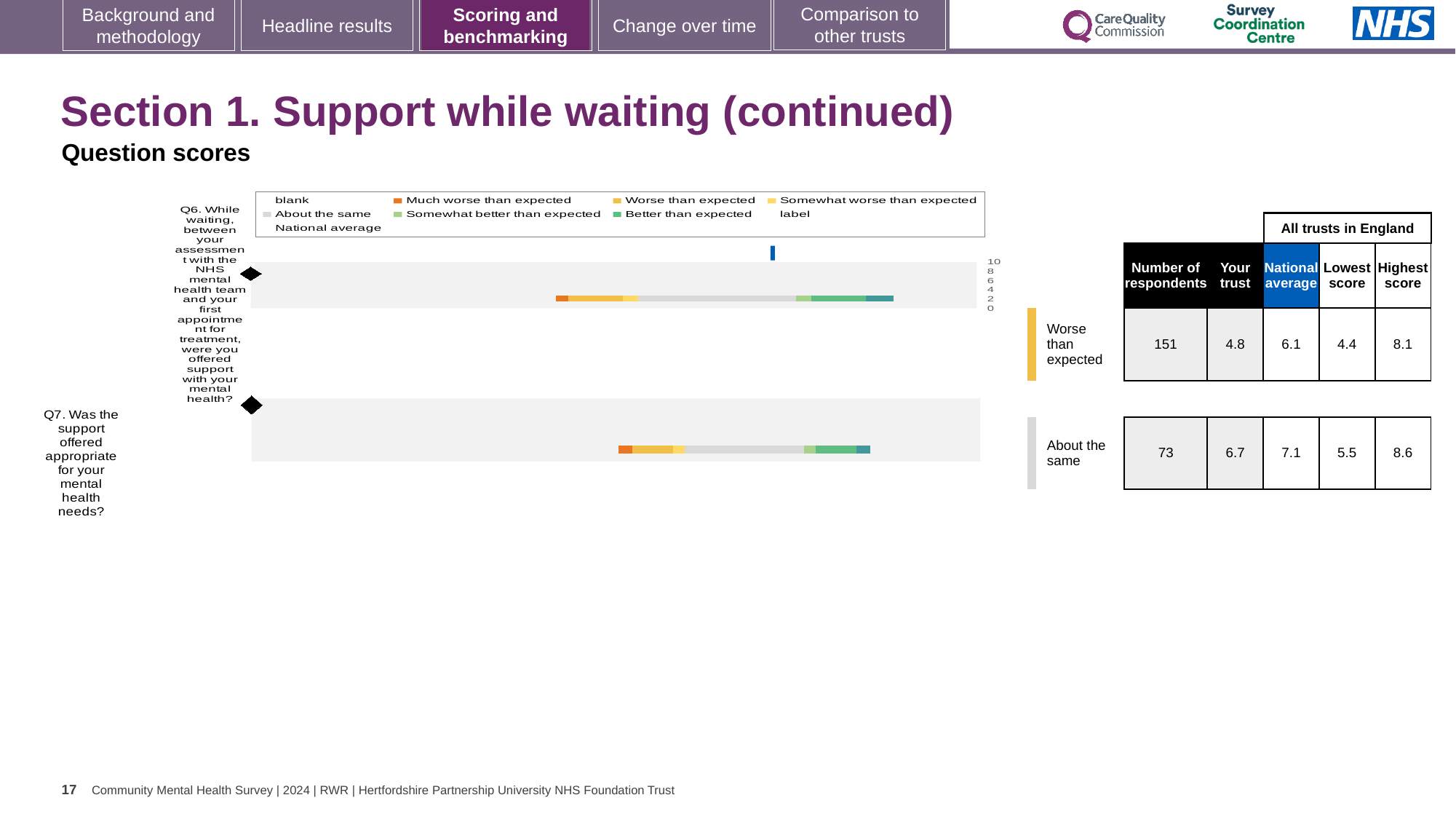
What is the difference between the national average and the 'Your trust' score for Q6? 1.3 Which legend entry is shown in orange? Much worse than expected What is the national average score for Q7? 7.1 How many questions (categories) are plotted in the chart? 2 How many entries does the chart legend list? 9 What is the 'Your trust' score for Q6? 4.8 What kind of chart is shown on the slide? bar chart Which question has the higher 'Your trust' score, Q6 or Q7? Q7 How many respondents answered Q6? 151 What benchmark category is shown for Q6 in the table next to the chart? Worse than expected What benchmark category is shown for Q7 in the table next to the chart? About the same What is the highest score among all trusts in England for Q7? 8.6